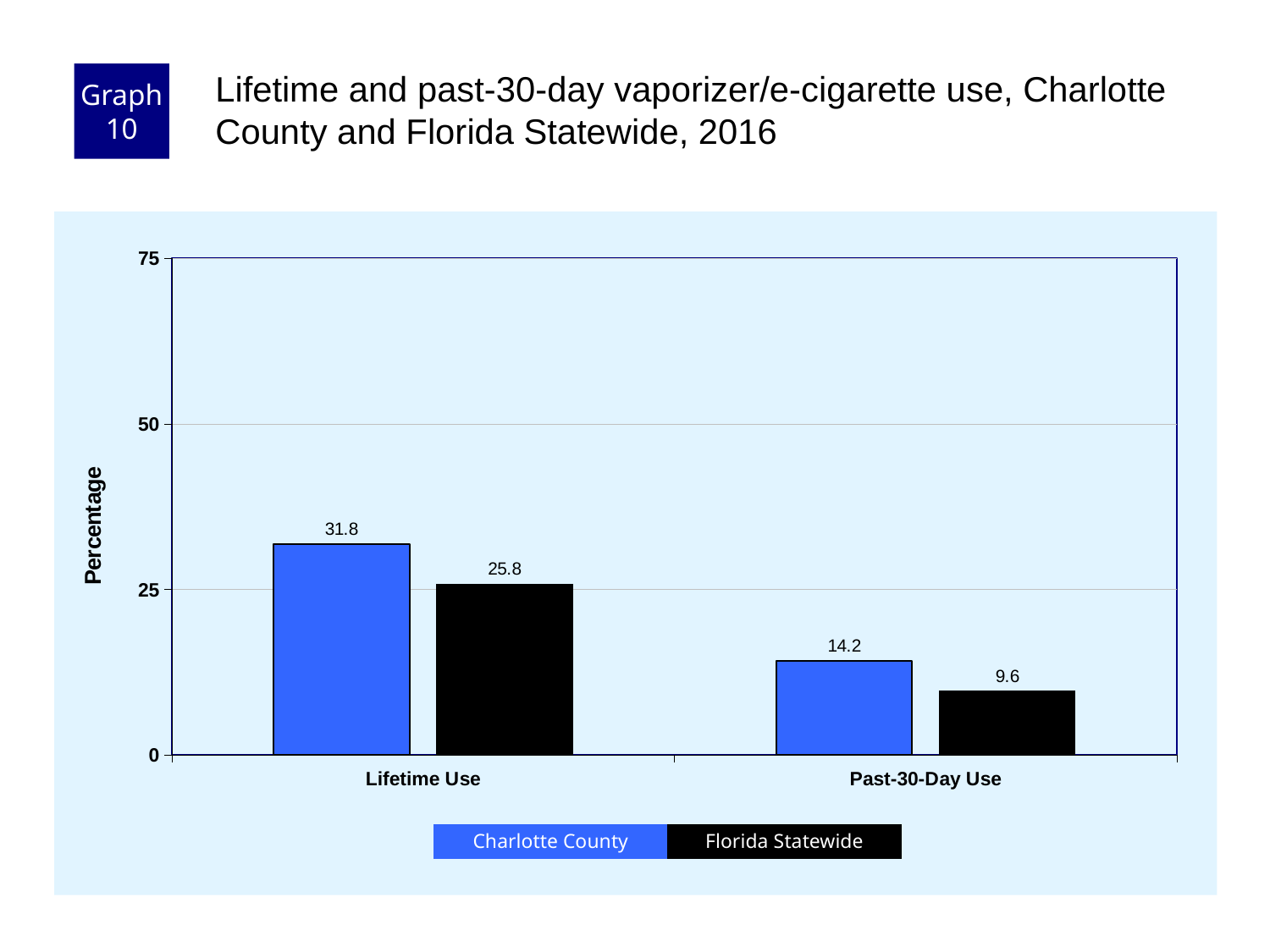
How many categories are shown on the x axis? 2 For Past-30-Day Use, which is larger: Charlotte County or Florida Statewide? Charlotte County Which bar has the highest value on the chart? Charlotte County, Lifetime Use Is the Charlotte County value for Lifetime Use greater or less than 25? greater What kind of chart is shown on the slide? bar chart What is the difference between the Charlotte County and Florida Statewide values for Past-30-Day Use? 4.6 What is the Florida Statewide value for Lifetime Use? 25.8 What is the Charlotte County value for Lifetime Use? 31.8 What is the Florida Statewide value for Past-30-Day Use? 9.6 What is the difference between the Charlotte County and Florida Statewide values for Lifetime Use? 6.0 Which bar has the lowest value on the chart? Florida Statewide, Past-30-Day Use How many series does the legend list? 2